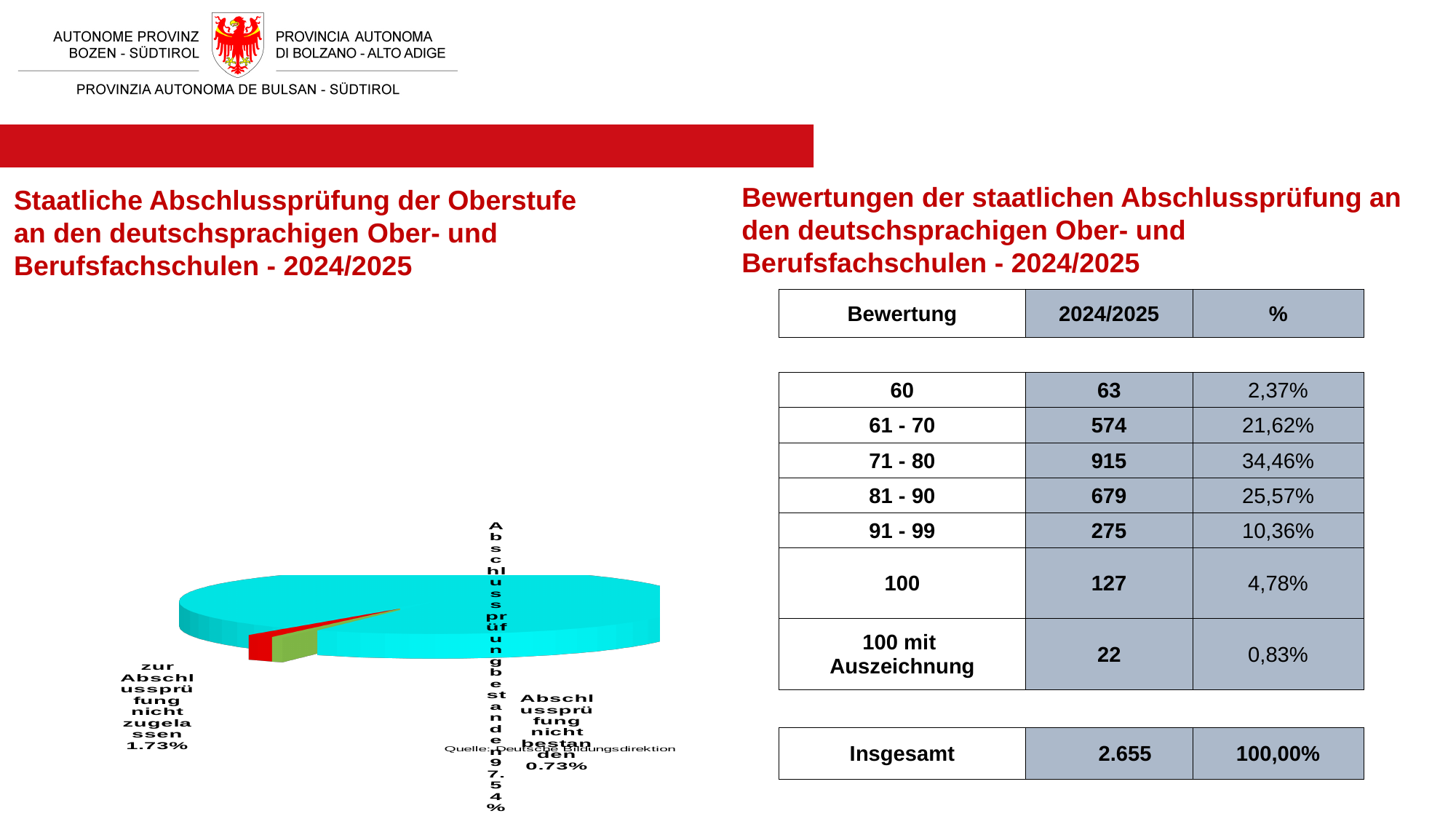
What kind of chart is shown on the left of the slide? pie chart Which slice of the pie chart is the largest? Abschlussprüfung bestanden What share of the pie chart is labelled "Abschlussprüfung nicht bestanden"? 0.73% In the pie chart, what is the difference in percentage points between "Abschlussprüfung bestanden" and "zur Abschlussprüfung nicht zugelassen"? 95.81% What source is cited below the pie chart? Quelle: Deutsche Bildungsdirektion What share of the pie chart is labelled "Abschlussprüfung bestanden"? 97.54% How many slices does the pie chart have? 3 What colour is the largest slice of the pie chart? cyan Which slice of the pie chart is the smallest? Abschlussprüfung nicht bestanden In the pie chart, what is the difference in percentage points between "zur Abschlussprüfung nicht zugelassen" and "Abschlussprüfung nicht bestanden"? 1.00% What share of the pie chart is labelled "zur Abschlussprüfung nicht zugelassen"? 1.73% In the pie chart, which is larger: "zur Abschlussprüfung nicht zugelassen" or "Abschlussprüfung nicht bestanden"? zur Abschlussprüfung nicht zugelassen